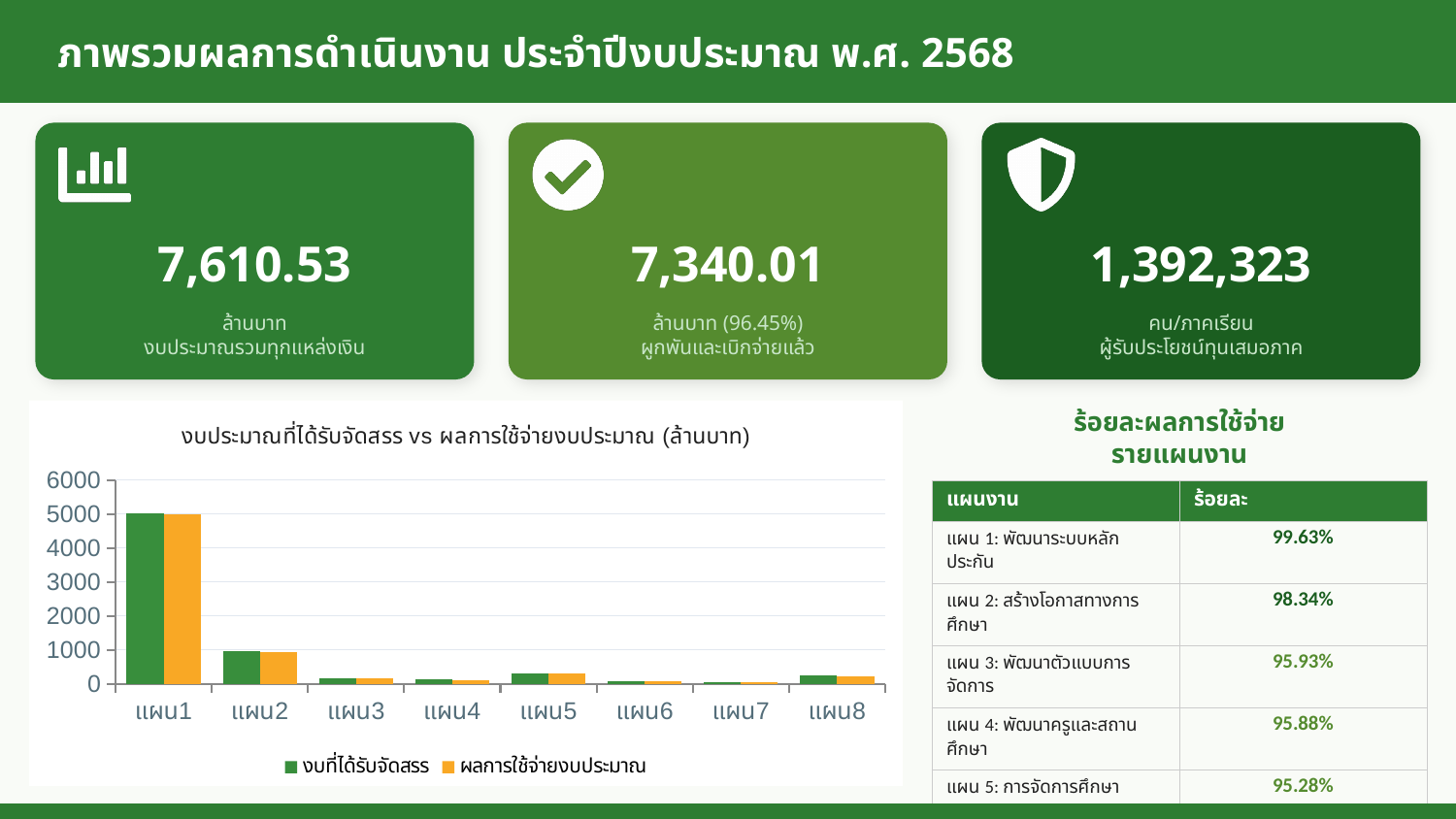
Which is larger in the bar chart: the งบที่ได้รับจัดสรร value for แผน1 or for แผน2? แผน1 Is the งบที่ได้รับจัดสรร value for แผน5 greater or less than 1000? less Which is larger in the bar chart: the งบที่ได้รับจัดสรร value for แผน5 or for แผน3? แผน5 What is the title of the bar chart? งบประมาณที่ได้รับจัดสรร vs ผลการใช้จ่ายงบประมาณ (ล้านบาท) Is the ผลการใช้จ่ายงบประมาณ value for แผน2 greater or less than 2000? less How many series does the legend of the bar chart list? 2 Which category has the highest งบที่ได้รับจัดสรร value in the bar chart? แผน1 How many categories (แผน) are shown on the x axis of the bar chart? 8 Which is larger in the bar chart: the ผลการใช้จ่ายงบประมาณ value for แผน8 or for แผน4? แผน8 Which series in the bar chart is shown in orange? ผลการใช้จ่ายงบประมาณ What kind of chart is shown on the slide? bar chart Is the งบที่ได้รับจัดสรร value for แผน1 greater or less than 4000? greater